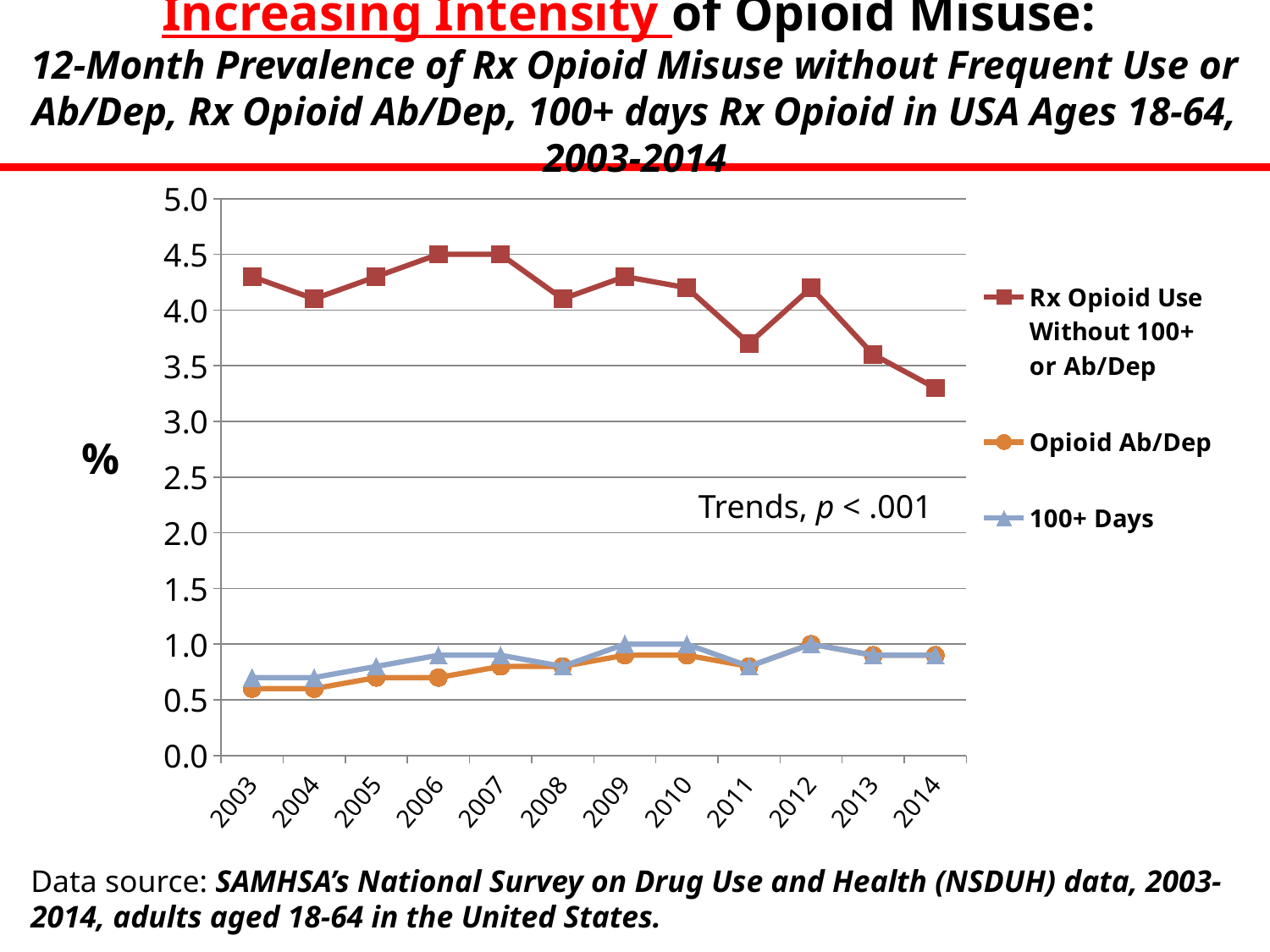
Does the Rx Opioid Use Without 100+ or Ab/Dep series rise or fall overall from 2003 to 2014? fall Which is larger for Rx Opioid Use Without 100+ or Ab/Dep: the value in 2003 or the value in 2014? 2003 How many series does the legend list? 3 Is the value for Rx Opioid Use Without 100+ or Ab/Dep in 2014 greater or less than 3.5? less How many years are plotted along the x axis? 12 What kind of chart is shown on the slide? line chart Is the value for Opioid Ab/Dep in 2003 greater or less than 0.5? greater Is the value for Rx Opioid Use Without 100+ or Ab/Dep in 2003 greater or less than 4.0? greater Does the Opioid Ab/Dep series rise or fall overall from 2003 to 2014? rise What label is shown on the y axis of the chart? % In which year is the value for Rx Opioid Use Without 100+ or Ab/Dep lowest? 2014